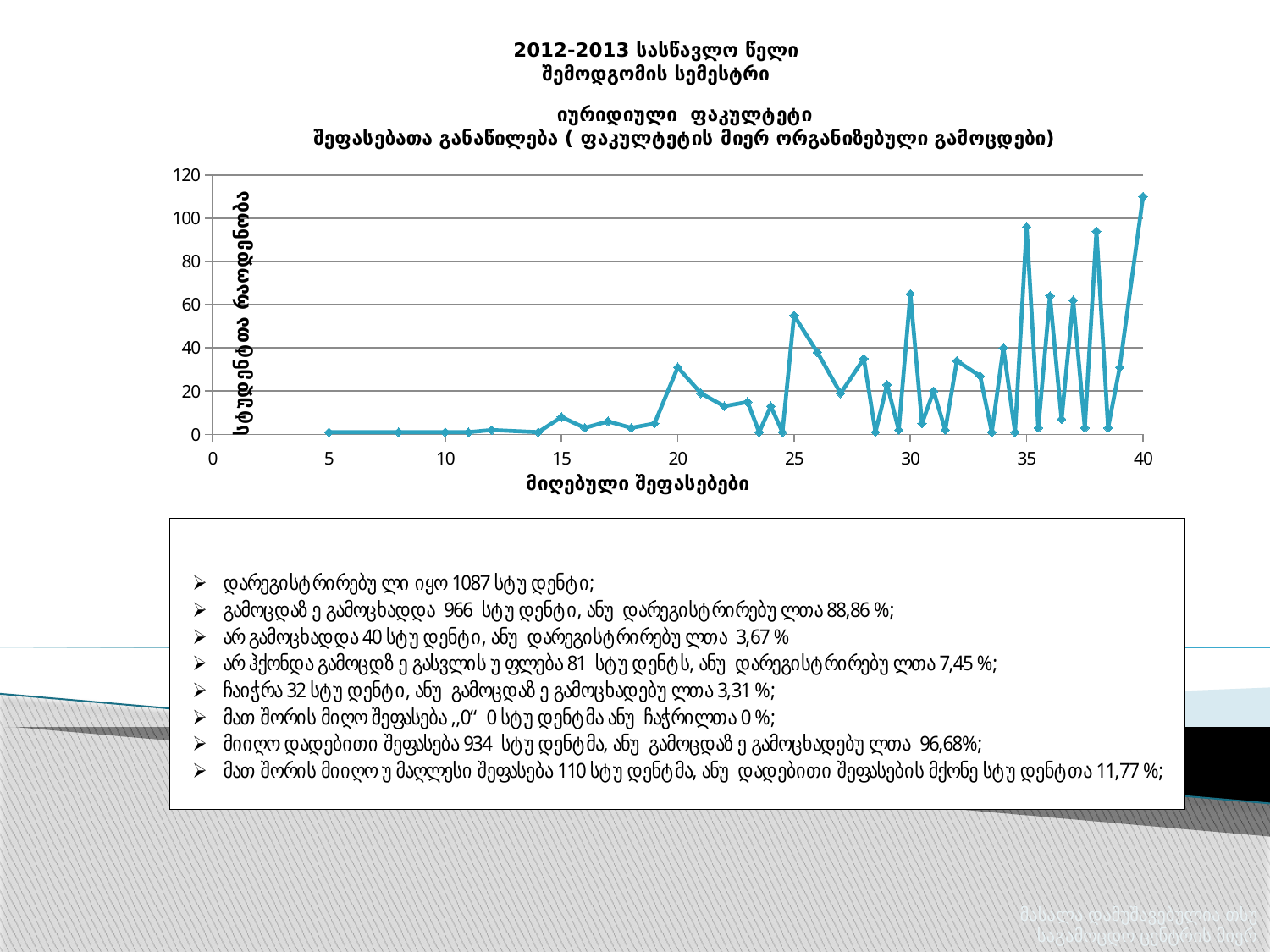
Which has the larger value, x = 35 or x = 25? 35 Is the value at x = 25 greater or less than 40? greater What kind of chart is shown on the slide? line chart At which x-axis value (მიღებული შეფასებები) does the line reach its highest point? 40 Is the value at x = 10 greater or less than 20? less Is the value at x = 35 greater or less than 80? greater What is the title of the x axis? მიღებული შეფასებები Overall, do the values rise or fall as the x-axis goes from 5 to 40? rise Which has the larger value, x = 20 or x = 25? 25